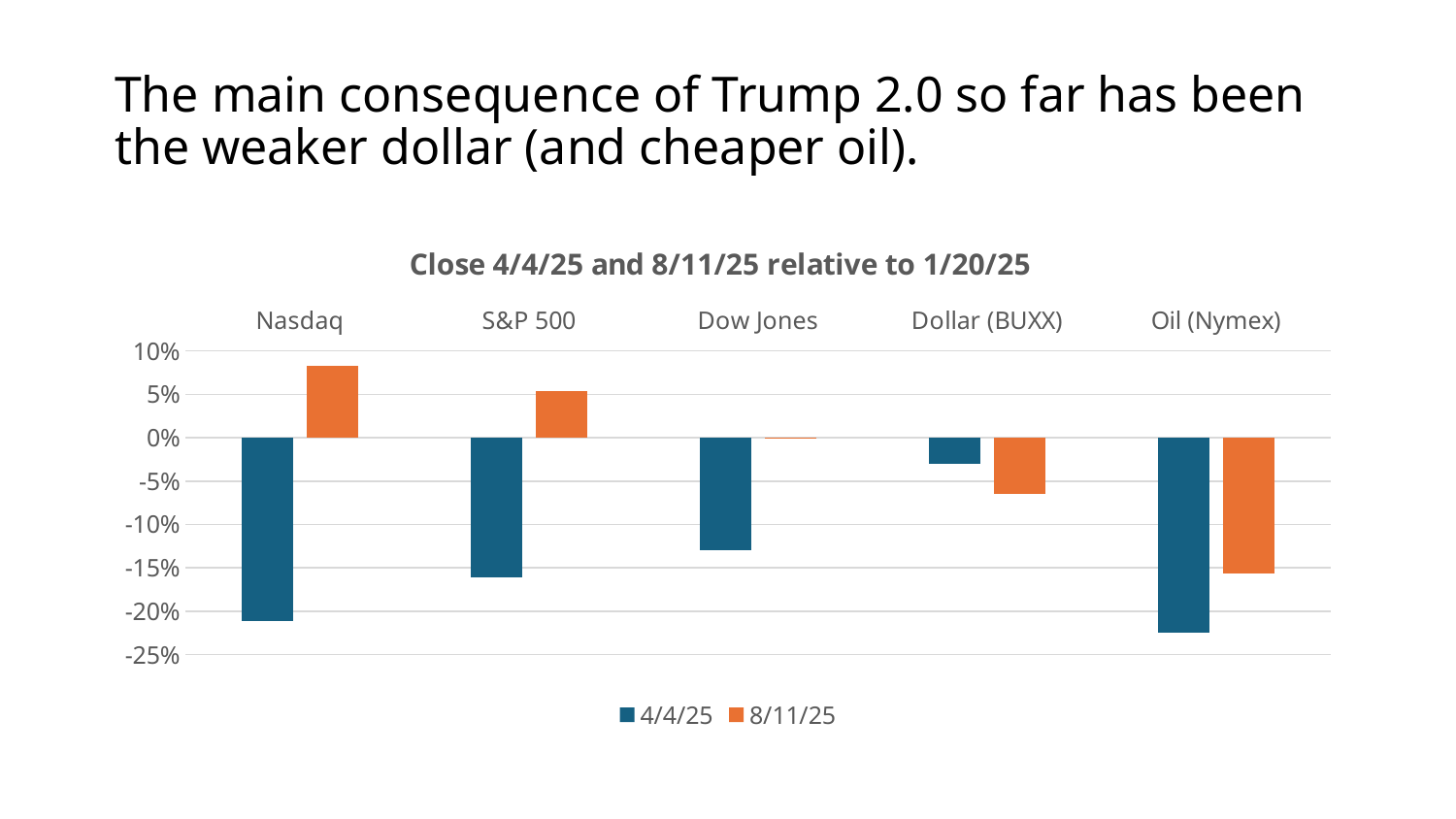
Is the 8/11/25 value for Nasdaq greater or less than 5%? greater Which category has the highest value for the 8/11/25 series? Nasdaq Which category has the lowest value for the 8/11/25 series? Oil (Nymex) Is the 4/4/25 value for Nasdaq greater or less than -15%? less For Dollar (BUXX), which series has the larger value, 4/4/25 or 8/11/25? 4/4/25 Is the 8/11/25 value for Oil (Nymex) greater or less than -10%? less What kind of chart is shown on the slide? bar chart For Oil (Nymex), which series has the larger value, 4/4/25 or 8/11/25? 8/11/25 How many categories are shown on the x axis? 5 What is the title of the chart? Close 4/4/25 and 8/11/25 relative to 1/20/25 How many series does the legend list? 2